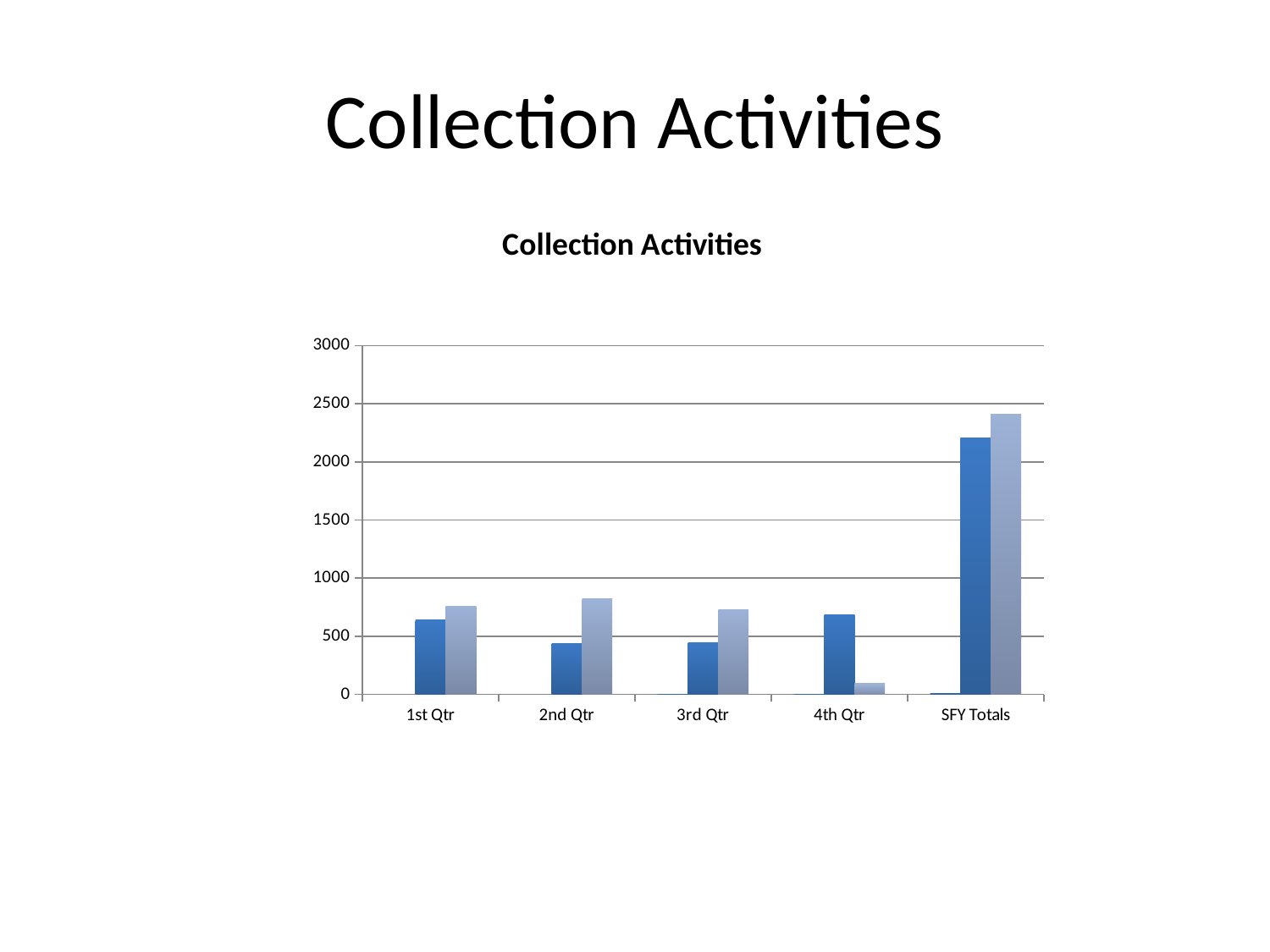
Is the dark blue bar for SFY Totals greater or less than 2000? greater Is the light blue bar for 4th Qtr greater or less than 500? less Which is larger, the dark blue bar for 1st Qtr or the dark blue bar for 2nd Qtr? 1st Qtr Which category has the tallest dark blue bar? SFY Totals Among the four quarters, which has the lowest light blue bar? 4th Qtr What is the title of the chart? Collection Activities For 2nd Qtr, which bar is taller, the dark blue bar or the light blue bar? the light blue bar Is the light blue bar for SFY Totals greater or less than 2500? less For 4th Qtr, which bar is taller, the dark blue bar or the light blue bar? the dark blue bar What kind of chart is shown on the slide? bar chart How many categories are shown on the x axis of the chart? 5